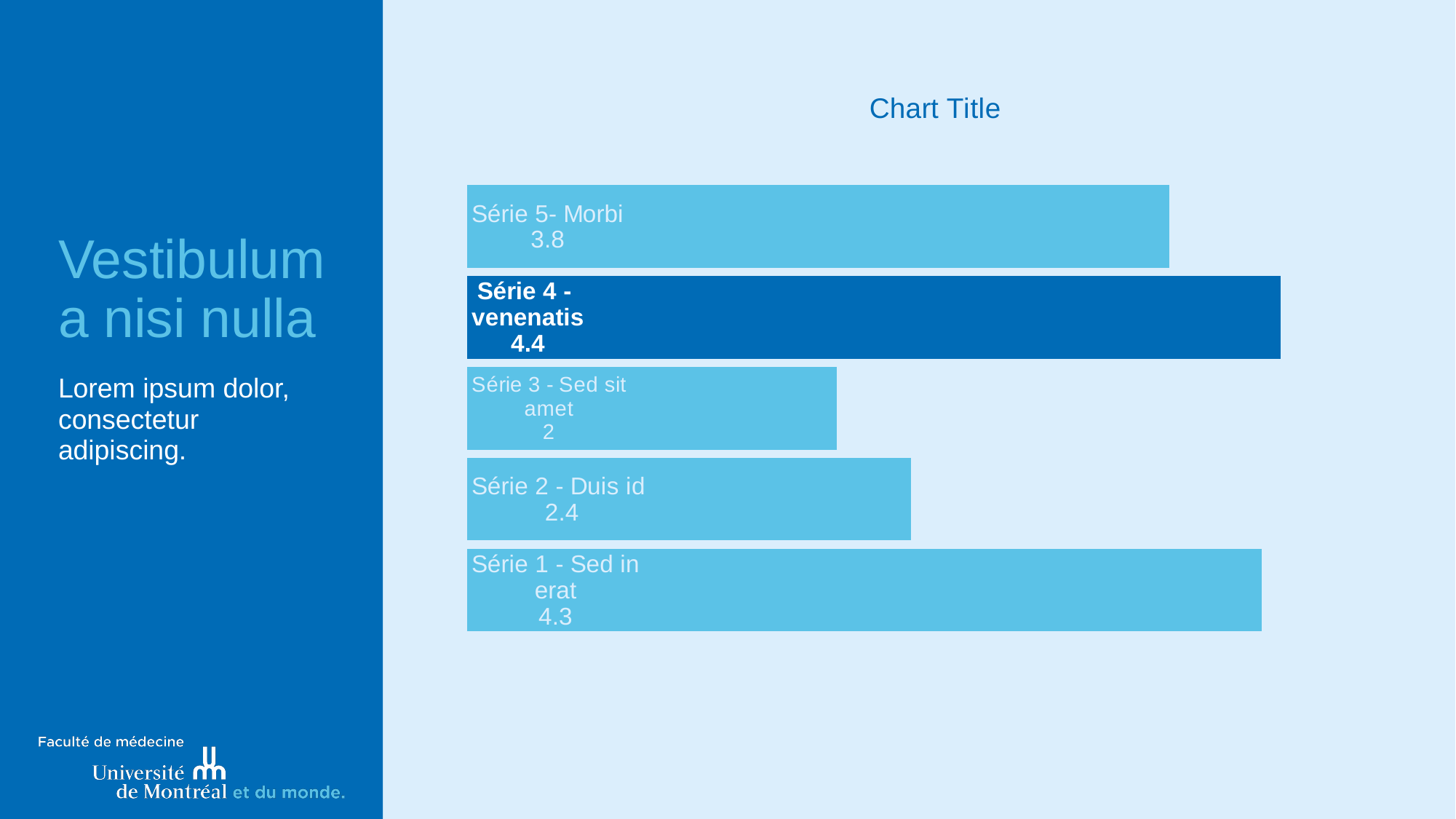
What is the difference between the values for Série 5 - Morbi and Série 2 - Duis id? 1.4 Which category has the lowest value? Série 3 - Sed sit amet What is the value for Série 5 - Morbi? 3.8 What type of chart is shown on the slide? Bar chart What is the value for Série 3 - Sed sit amet? 2 Which category has the highest value? Série 4 - venenatis Which bar is drawn in a darker blue than the others? Série 4 - venenatis Which is larger, the value for Série 2 - Duis id or the value for Série 3 - Sed sit amet? Série 2 - Duis id How many bars does the chart show? 5 What is the value for Série 4 - venenatis? 4.4 What is the value for Série 1 - Sed in erat? 4.3 What is the title of the chart? Chart Title